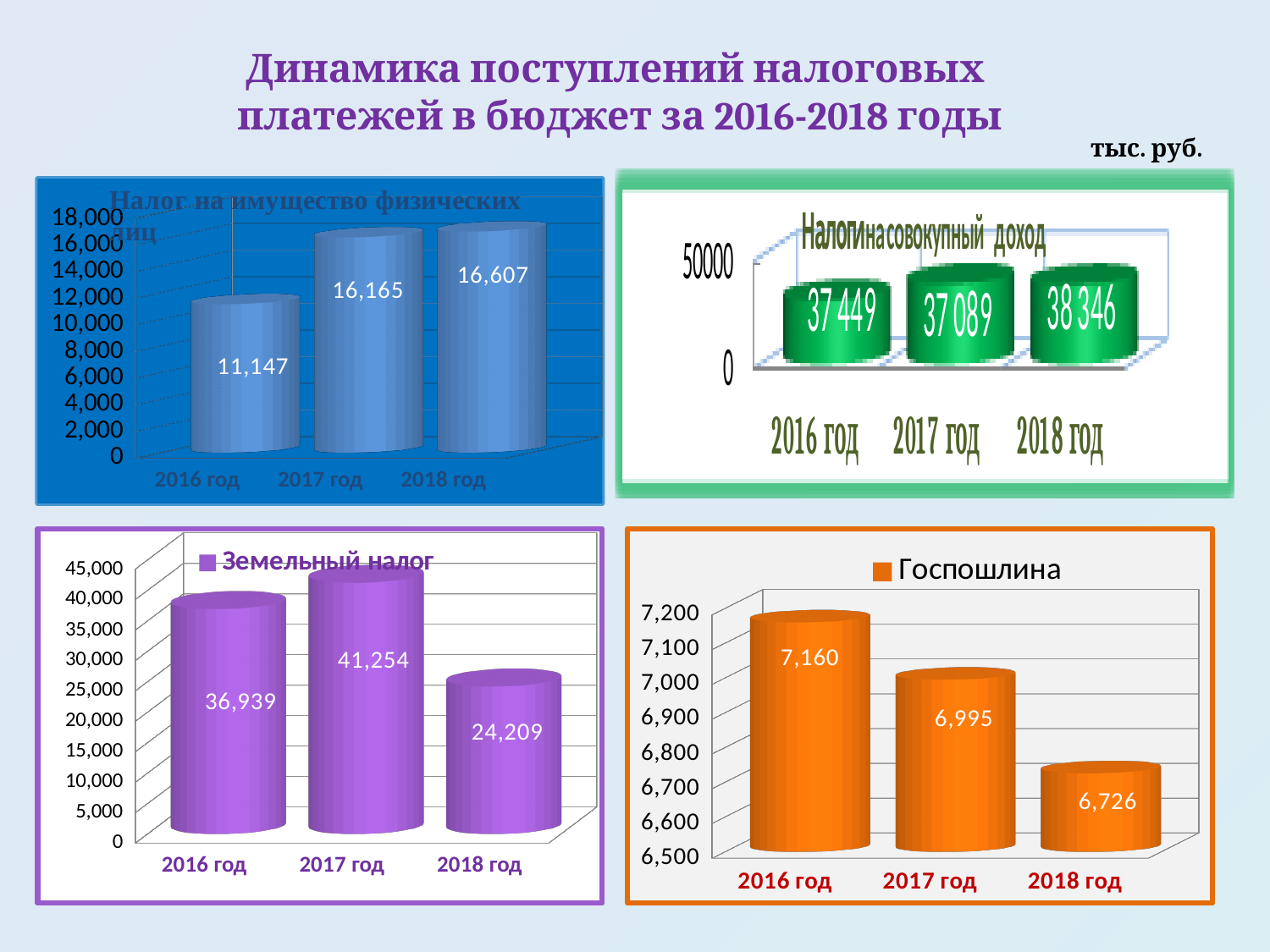
What type of chart is the 'Земельный налог' chart (bottom left)? bar chart In the 'Налог на совокупный доход' chart (top right), what is the value for 2017 год? 37 089 In the 'Госпошлина' chart (bottom right), what is the value for 2018 год? 6,726 In the 'Земельный налог' chart (bottom left), which is larger: the value for 2016 год or 2018 год? 2016 год In the 'Налог на имущество физических лиц' chart (top left), which year has the highest value? 2018 год In the 'Налог на совокупный доход' chart (top right), which year has the lowest value? 2017 год In the 'Налог на имущество физических лиц' chart (top left), what is the value for 2016 год? 11,147 In the 'Земельный налог' chart (bottom left), what is the value for 2017 год? 41,254 In the 'Налог на имущество физических лиц' chart (top left), what is the difference between the 2018 год and 2016 год values? 5,460 In the 'Земельный налог' chart (bottom left), what is the difference between the 2017 год and 2018 год values? 17,045 In the 'Госпошлина' chart (bottom right), do the values rise or fall from 2016 год to 2018 год? fall How many years (categories) are shown in the 'Госпошлина' chart (bottom right)? 3